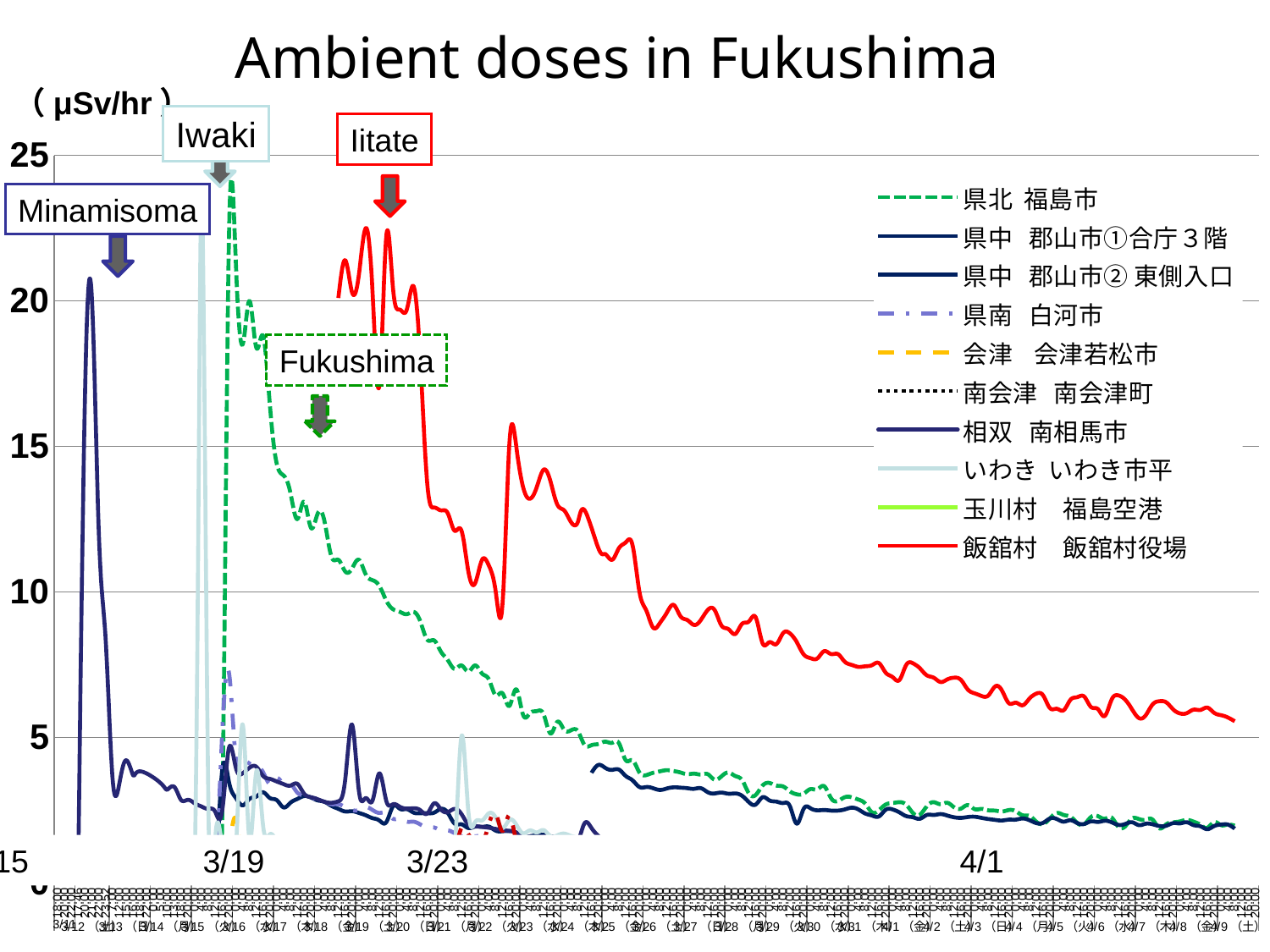
Is the peak value of the Minamisoma line greater or less than 15? greater Is the peak value of the Iitate line greater or less than 20? greater What is the title of the chart? Ambient doses in Fukushima At 4/1, which line has the larger value, Iitate or Fukushima? Iitate Is the value of the Iitate line at 4/1 greater or less than 5? greater What kind of chart is shown on the slide? line chart After its peak, does the Iitate line rise or fall as time moves toward 4/1? fall How many series does the chart legend list? 10 What unit is shown for the y axis of the chart? μSv/hr